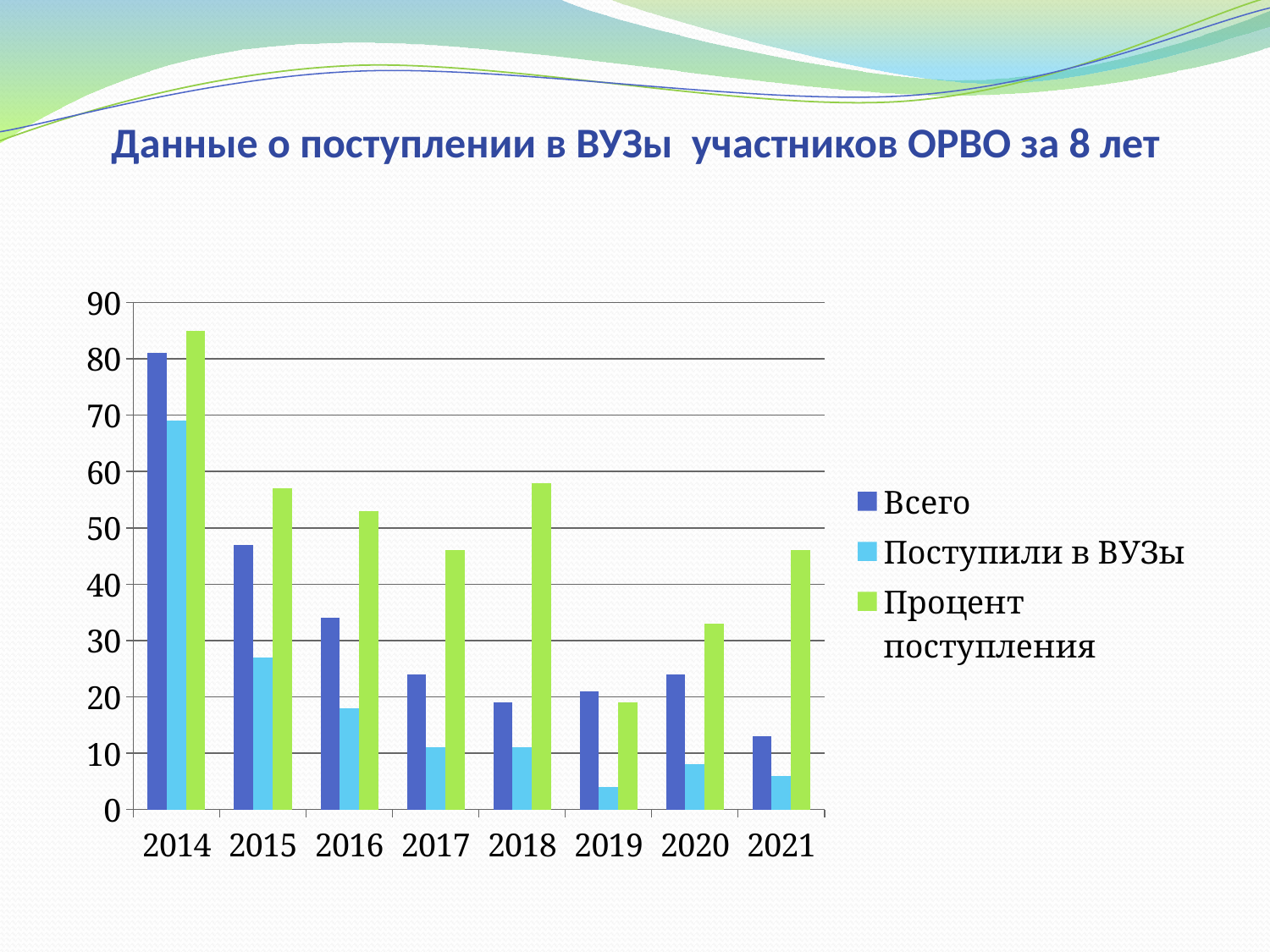
What kind of chart is shown on the slide? bar chart Which is larger, the value for Процент поступления in 2017 or in 2018? 2018 Is the value for Процент поступления in 2019 greater or less than 30? less Does the value for Всего rise or fall from 2014 to 2018? fall In which year is the value for Всего the highest? 2014 How many series does the legend list? 3 Is the value for Поступили в ВУЗы in 2014 greater or less than 60? greater How many years are shown on the x axis of the chart? 8 In which year is the value for Процент поступления the highest? 2014 What is the title of the chart on the slide? Данные о поступлении в ВУЗы участников ОРВО за 8 лет Is the value for Всего in 2014 greater or less than 70? greater In which year is the value for Поступили в ВУЗы the lowest? 2019